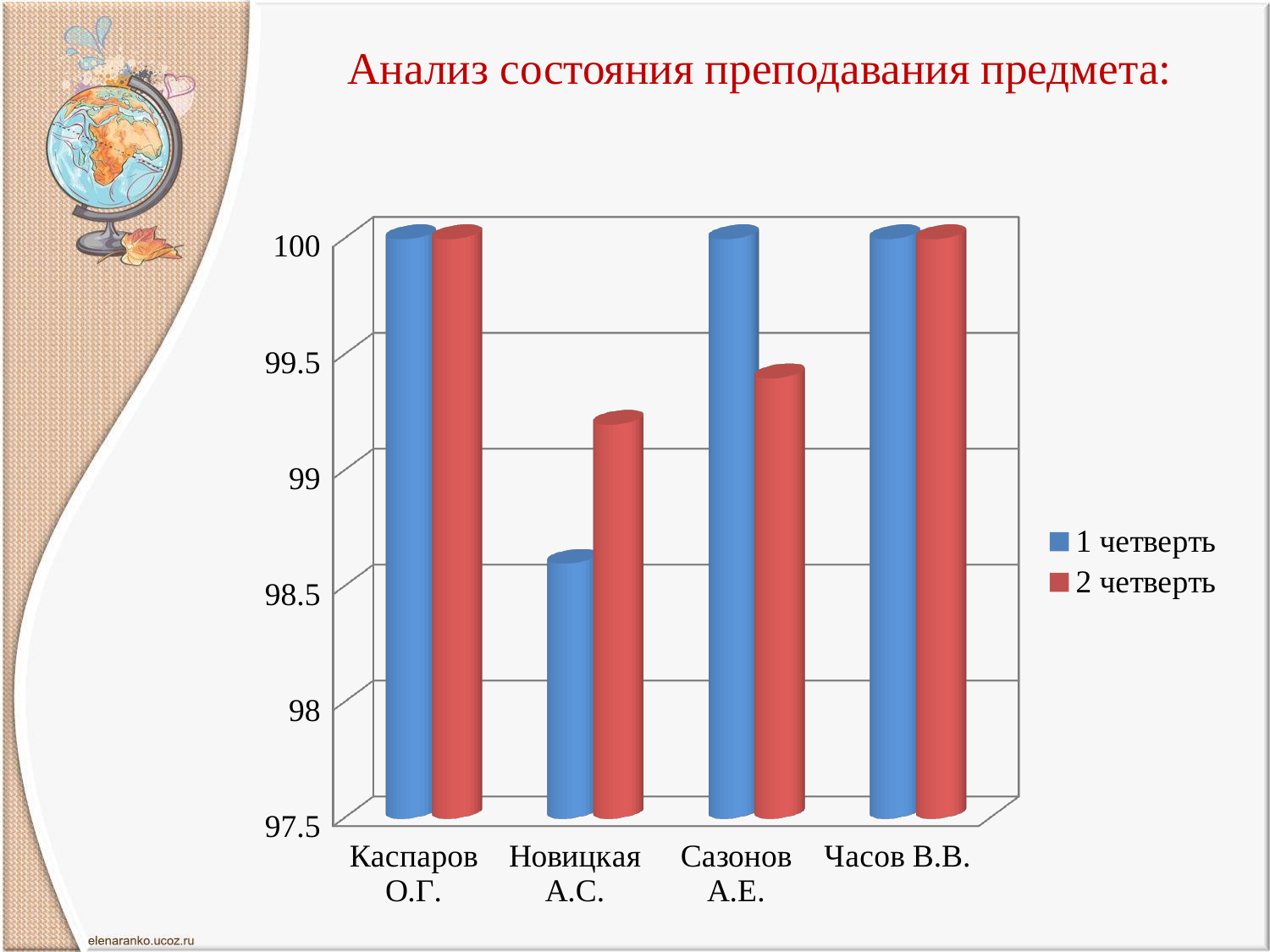
Which colour represents the series "2 четверть" in the chart? red How many teachers (categories) are shown on the x axis of the chart? 4 What is the title of the slide with the chart? Анализ состояния преподавания предмета: For Сазонов А.Е., which is larger: the "1 четверть" value or the "2 четверть" value? 1 четверть Which teacher has the lowest value for "2 четверть"? Новицкая А.С. Is the "2 четверть" value for Новицкая А.С. greater or less than 99? greater Is the "1 четверть" value for Новицкая А.С. greater or less than 99? less How many series does the chart legend list? 2 Which teacher has the lowest value for "1 четверть"? Новицкая А.С. For Новицкая А.С., which is larger: the "1 четверть" value or the "2 четверть" value? 2 четверть What kind of chart is shown on the slide? bar chart Is the "2 четверть" value for Сазонов А.Е. greater or less than 99.5? less